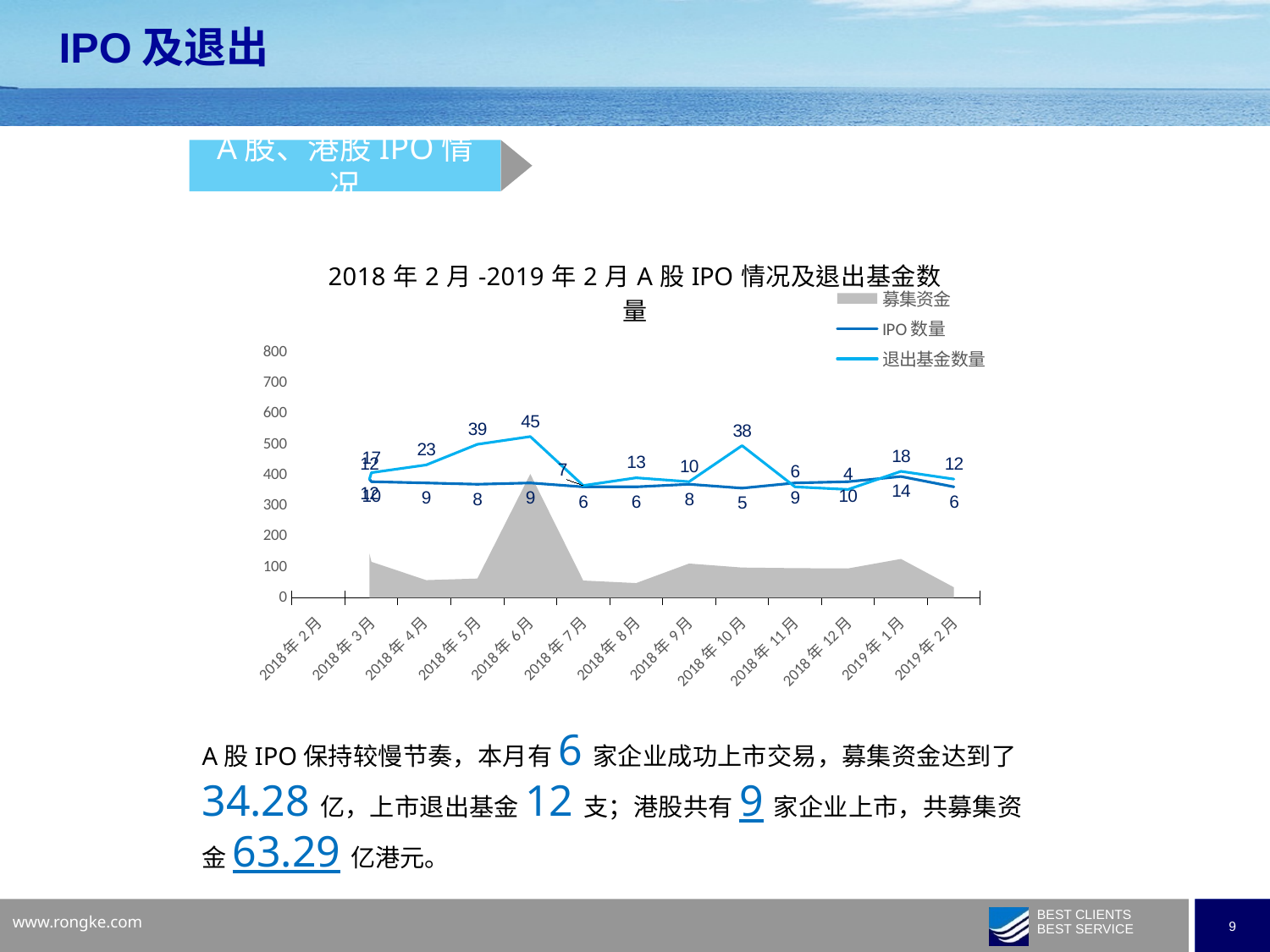
Does 退出基金数量 rise or fall from 2018年4月 to 2018年6月? rise How many series does the legend list? 3 In which month is 退出基金数量 lowest? 2018年12月 In which month is IPO 数量 lowest? 2018年10月 What is the difference between 退出基金数量 in 2018年6月 and 2018年7月? 38 Which month has a larger 退出基金数量, 2018年4月 or 2018年8月? 2018年4月 Is the 募集资金 value for 2018年6月 greater or less than 300? greater How many months are shown on the x axis? 13 In which month is 退出基金数量 highest? 2018年6月 What is the value of 退出基金数量 for 2018年10月? 38 What kind of chart is used to plot the IPO 数量 and 退出基金数量 series? line chart What is the value of IPO 数量 for 2019年1月? 14